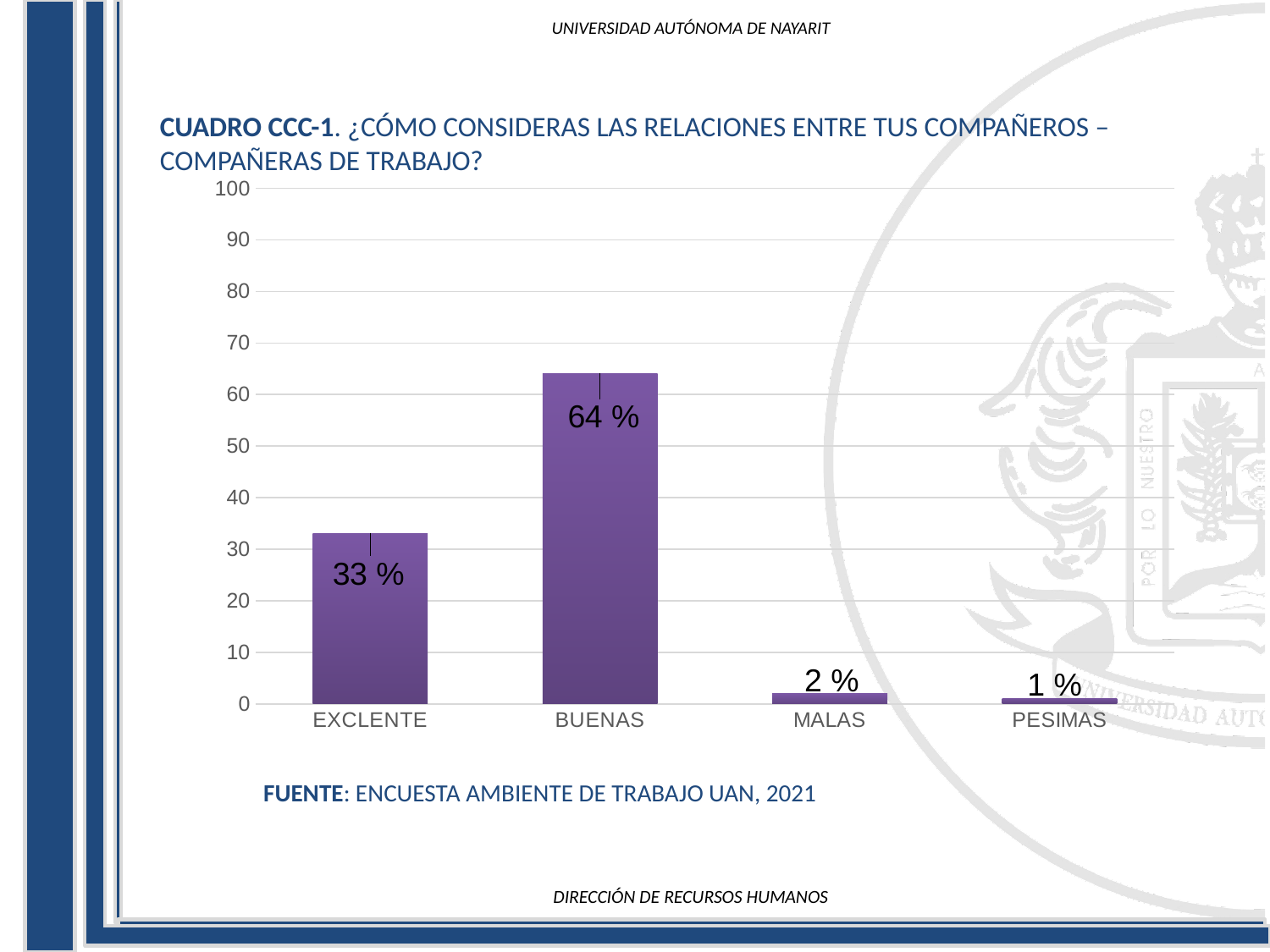
Which category has the lowest value? PESIMAS What is the value for PESIMAS? 1 % What is the value for EXCLENTE? 33 % What is the value for BUENAS? 64 % What is the difference between the values for BUENAS and EXCLENTE? 31 % What is the value for MALAS? 2 % Which category has the highest value? BUENAS Which is larger, the value for EXCLENTE or the value for MALAS? EXCLENTE Is the value for BUENAS greater or less than 50? greater How many categories are shown on the x axis? 4 What source is cited below the chart? ENCUESTA AMBIENTE DE TRABAJO UAN, 2021 What kind of chart is shown on the slide? bar chart